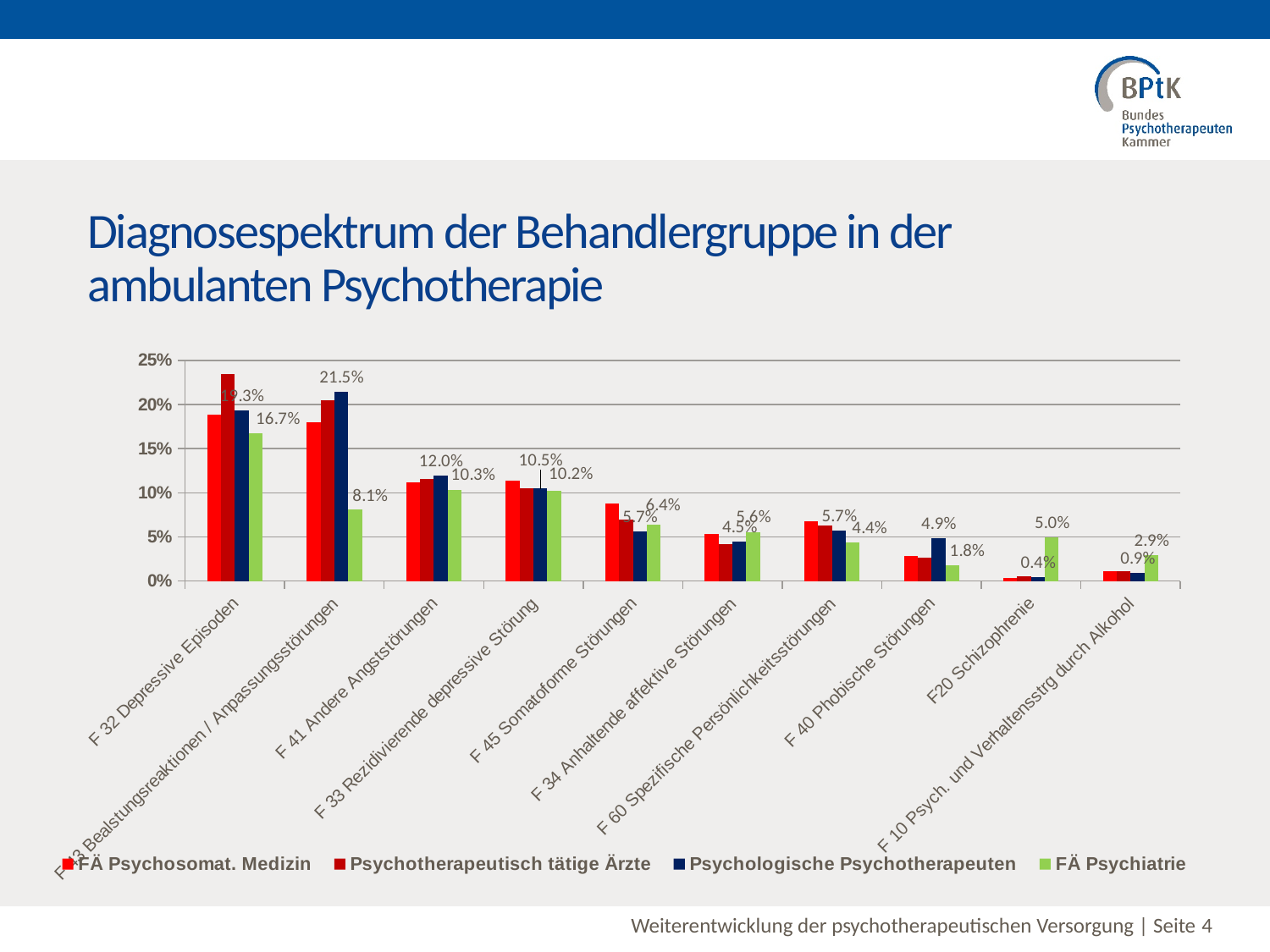
Is the value for FÄ Psychosomat. Medizin in the category F 32 Depressive Episoden greater or less than 15%? greater What is the value for Psychologische Psychotherapeuten in the category F 43 Belastungsreaktionen / Anpassungsstörungen? 21.5% In the category F20 Schizophrenie, which is larger: the value for Psychologische Psychotherapeuten or for FÄ Psychiatrie? FÄ Psychiatrie In the category F 43 Belastungsreaktionen / Anpassungsstörungen, what is the difference between the values for Psychologische Psychotherapeuten and FÄ Psychiatrie? 13.4 percentage points Which category has the highest value for Psychologische Psychotherapeuten? F 43 Belastungsreaktionen / Anpassungsstörungen What kind of chart is shown on the slide? bar chart How many series does the legend list? 4 How many diagnosis categories are shown on the x axis? 10 What is the value for FÄ Psychiatrie in the category F20 Schizophrenie? 5.0% What is the value for Psychologische Psychotherapeuten in the category F 40 Phobische Störungen? 4.9% What is the value for FÄ Psychiatrie in the category F 32 Depressive Episoden? 16.7% Which category has the lowest value for FÄ Psychiatrie? F 40 Phobische Störungen